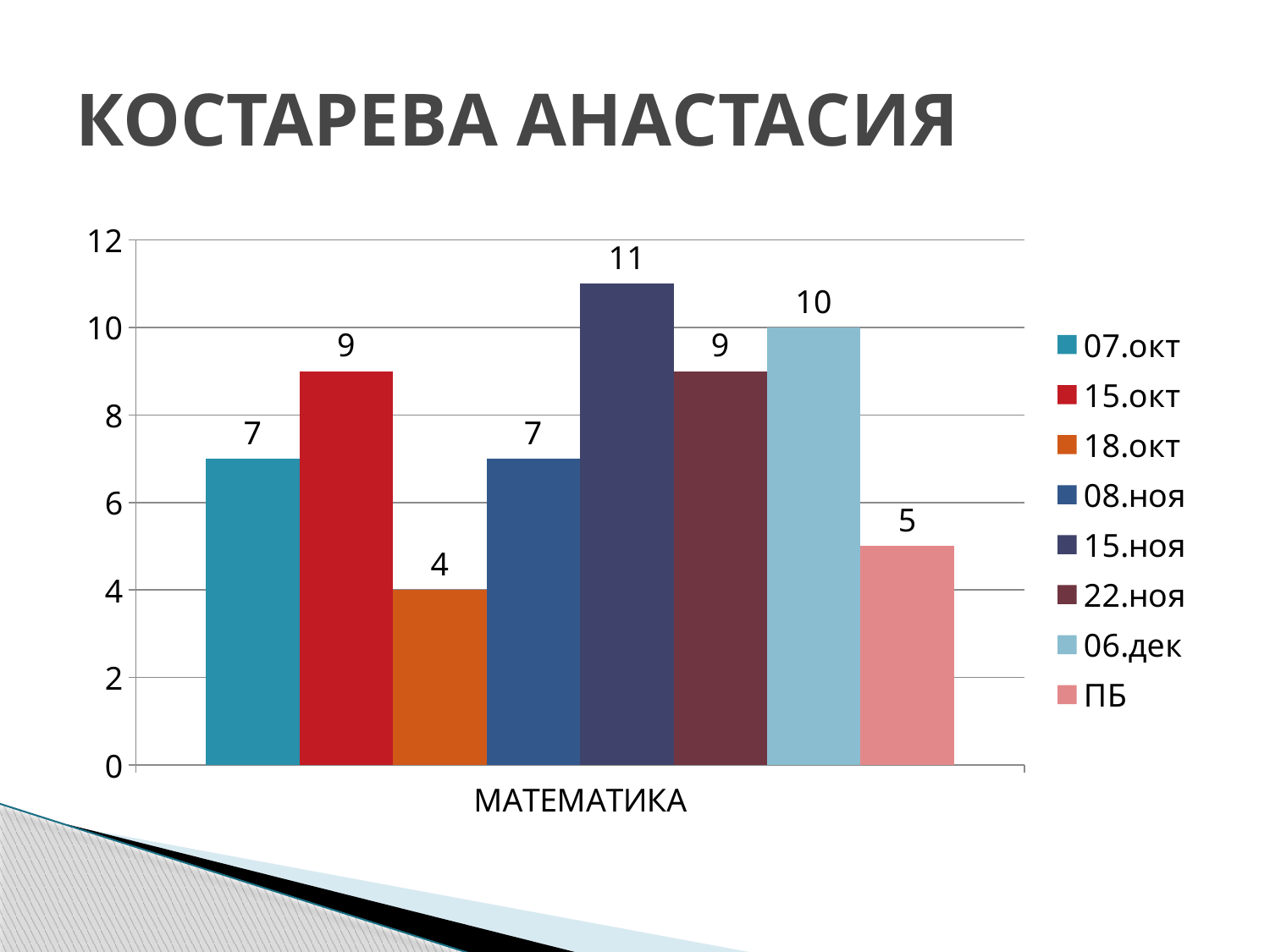
Which is larger, the value for 15.окт or the value for 06.дек? 06.дек How many series does the legend list? 8 What kind of chart is shown on the slide? bar chart What is the value for ПБ? 5 Which series has the lowest value? 18.окт What is the value for 18.окт? 4 Is the value for 22.ноя greater or less than 8? greater What is the difference between the values for 15.ноя and 18.окт? 7 What is the value for 06.дек? 10 What is the category label on the x axis? МАТЕМАТИКА Which series has the highest value? 15.ноя What is the value for 07.окт in the МАТЕМАТИКА chart? 7